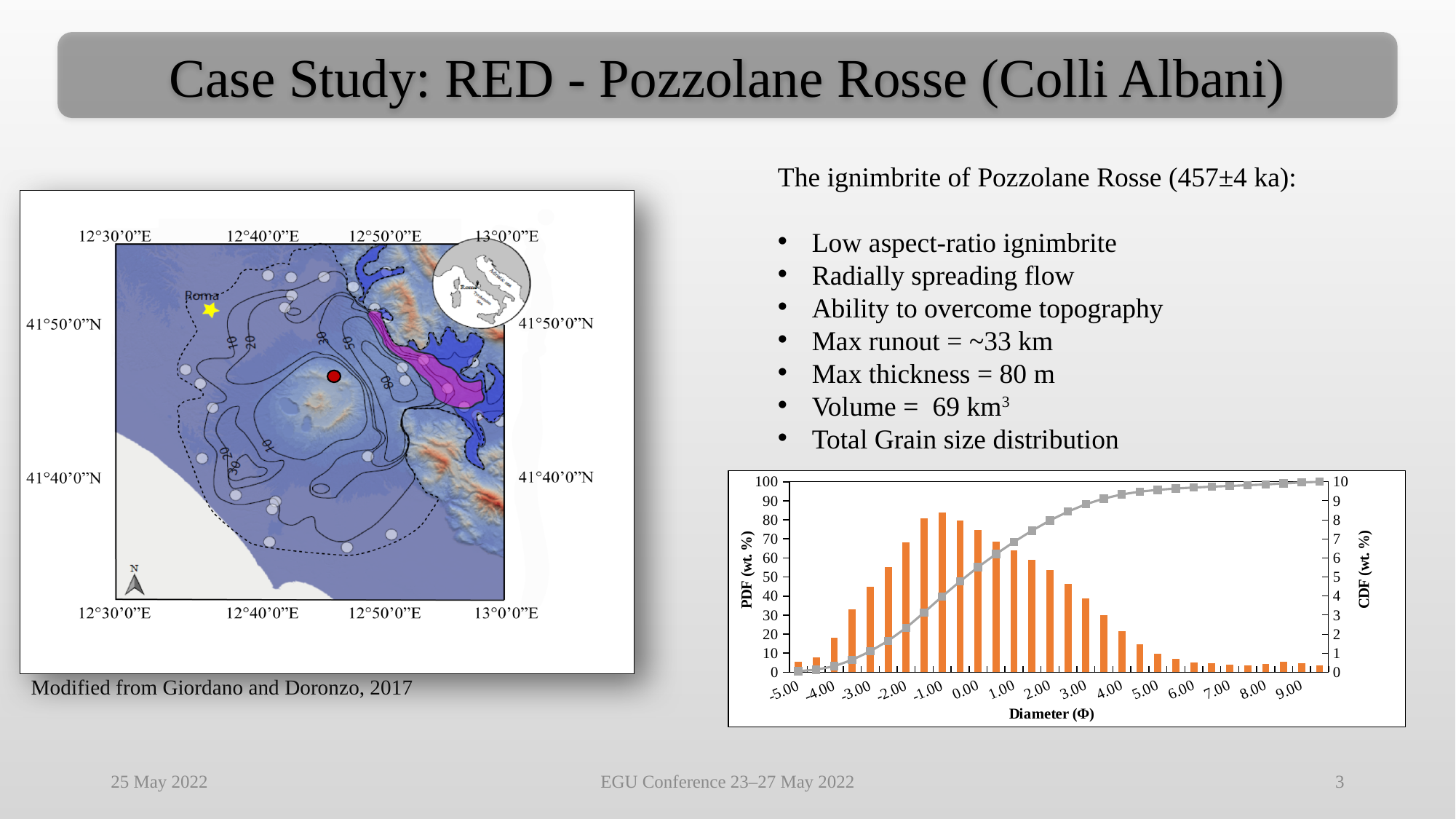
In the grain size distribution chart, does the grey line (CDF) rise or fall as the diameter increases along the x axis? Rises In the grain size distribution chart, is the PDF bar at diameter 0.00 greater or less than 70? greater In the grain size distribution chart, is the PDF bar at diameter 5.00 greater or less than 20? less In the grain size distribution chart, is the CDF value at diameter -4.00 greater or less than 1 on the right axis? less In the grain size distribution chart, what is the title of the left y axis? PDF (wt. %) In the grain size distribution chart, which PDF bar is taller: the one at diameter -2.00 or the one at diameter 2.00? -2.00 In the grain size distribution chart, what is the title of the x axis? Diameter (Φ) What kind of chart is shown on the slide (the grain size distribution chart)? A combined bar and line chart